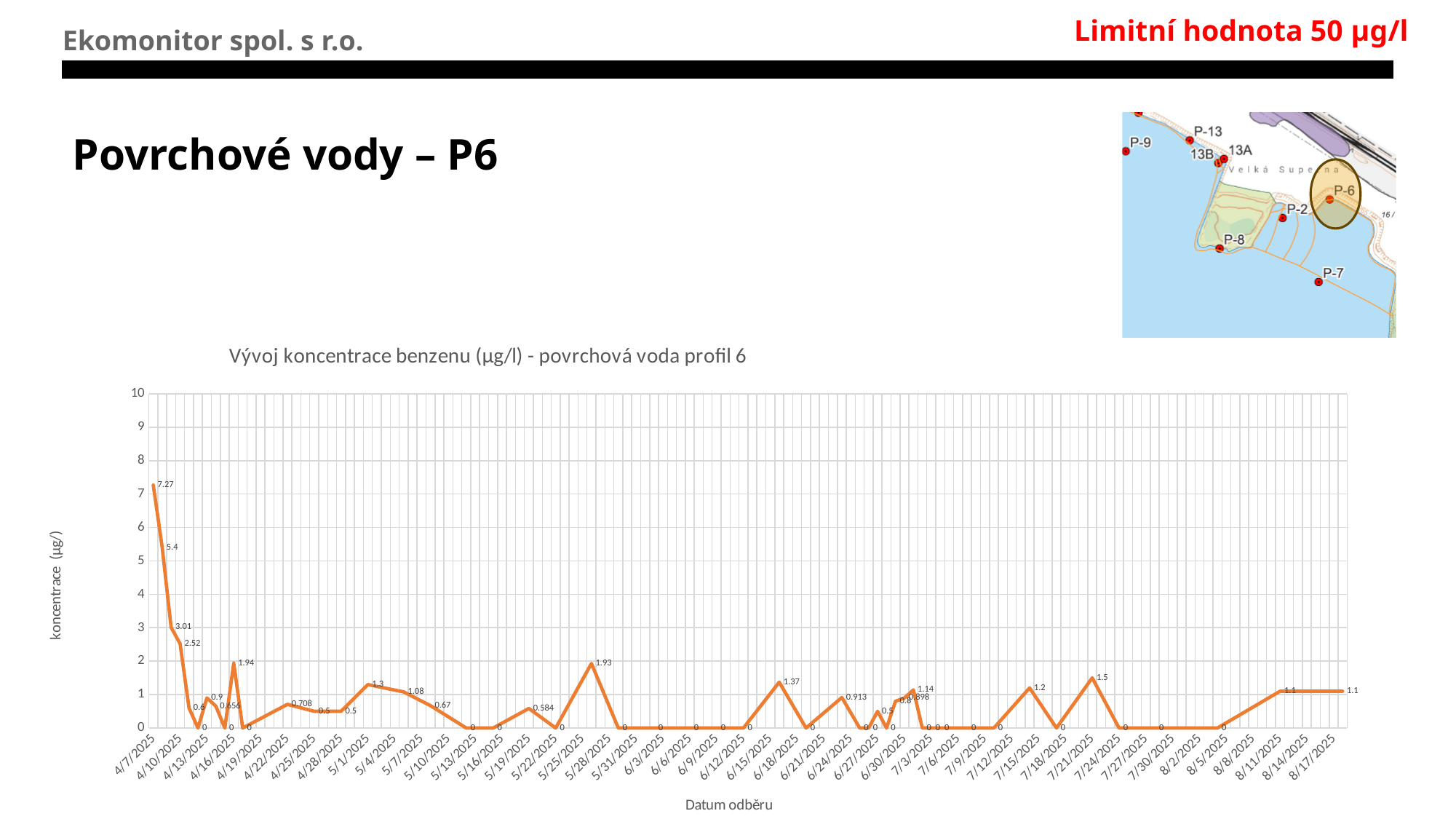
How many date labels are shown on the x axis? 45 What type of chart is shown on the slide? line chart What is the highest benzene concentration value plotted on the chart? 7.27 What is the lowest concentration value plotted on the chart? 0 Is the highest plotted value greater or less than 5? greater What is the label of the y axis? koncentrace (µg/l) Do the concentration values rise or fall over the first few sampling dates in April 2025? fall What is the concentration value at the first sampling date, 4/7/2025? 7.27 What is the concentration value at the last sampling date, 8/17/2025? 1.1 Which is larger: the first plotted value (7.27) or the peak around 5/28/2025 (1.93)? 7.27 What is the difference between the first two plotted values, 7.27 and 5.4? 1.87 What is the title of the chart? Vývoj koncentrace benzenu (µg/l) - povrchová voda profil 6